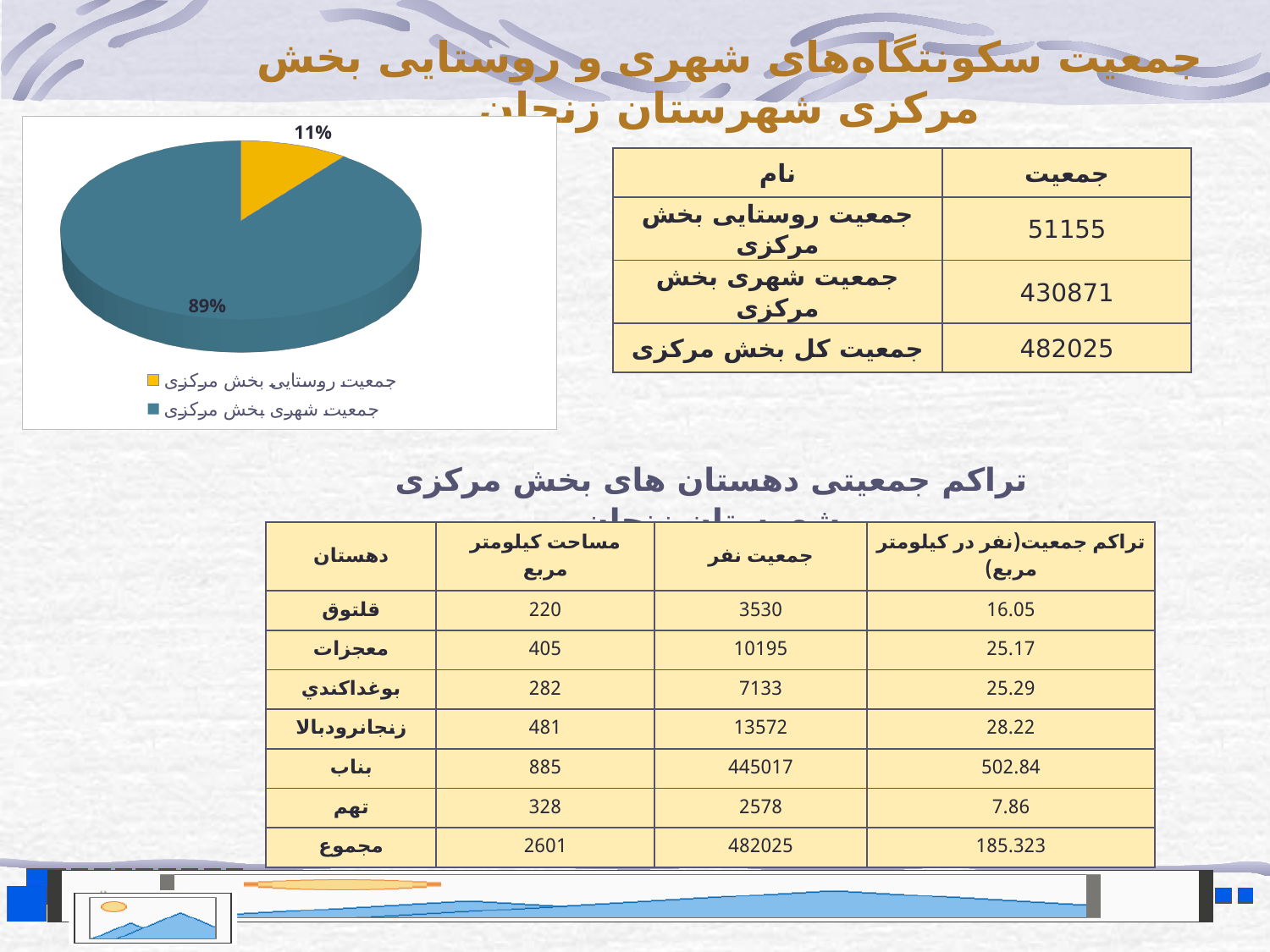
Which is larger in the pie chart: the rural population slice or the urban population slice? The urban population slice (جمعیت شهری بخش مرکزی) How many slices does the pie chart have? 2 Which slice of the pie chart is the largest? جمعیت شهری بخش مرکزی (urban population of the central district) What type of chart is shown on the slide? Pie chart What colour is the slice for جمعیت شهری بخش مرکزی (urban population) in the pie chart? Teal What is the difference in percentage points between the urban slice and the rural slice in the pie chart? 78 percentage points What colour is the slice for جمعیت روستایی بخش مرکزی (rural population) in the pie chart? Yellow How many entries does the pie chart's legend list? 2 What share of the pie does the slice for جمعیت شهری بخش مرکزی (urban population of the central district) represent? 89% Which slice of the pie chart is the smallest? جمعیت روستایی بخش مرکزی (rural population of the central district) What share of the pie does the slice for جمعیت روستایی بخش مرکزی (rural population of the central district) represent? 11%